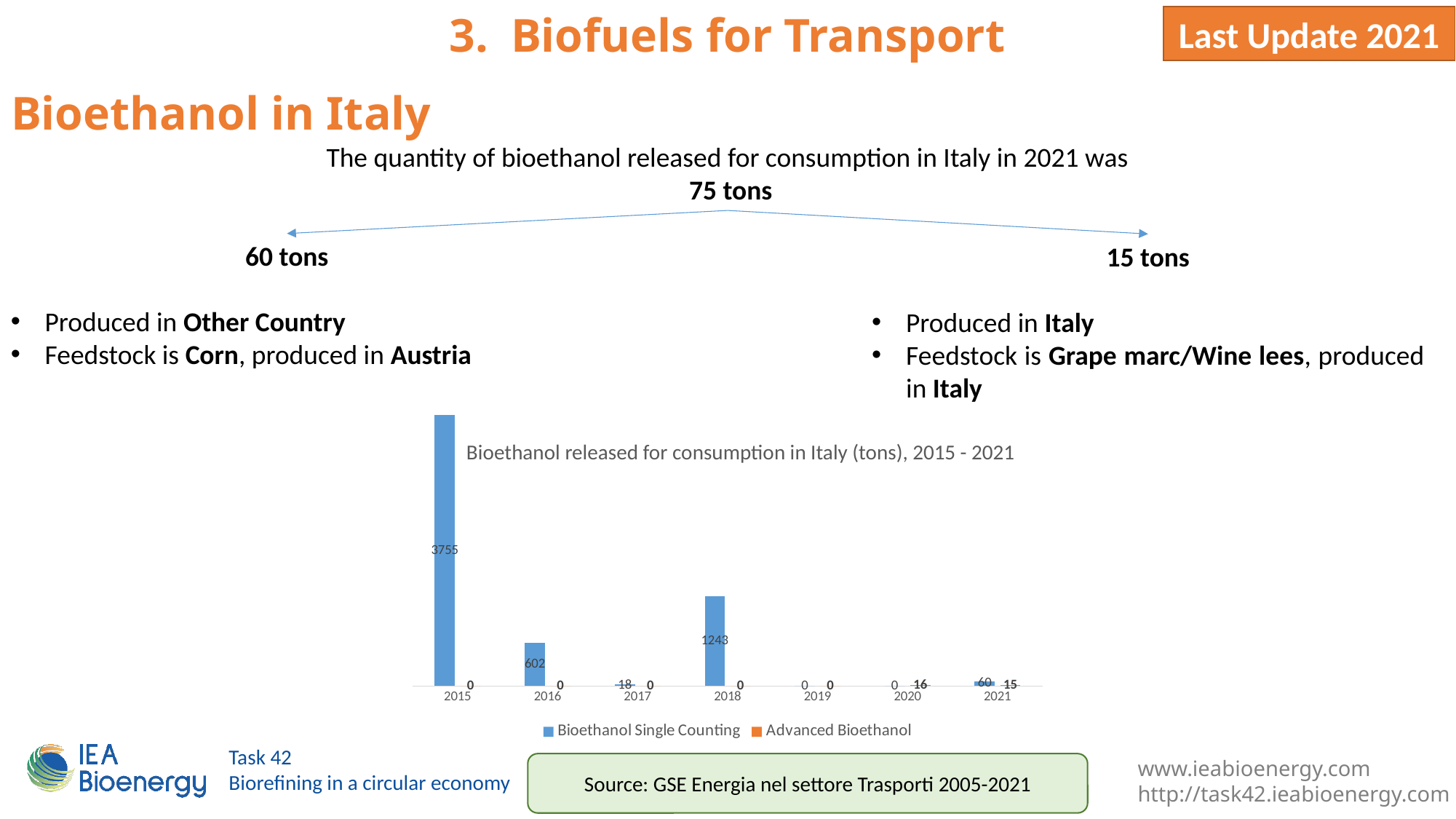
What is the Bioethanol Single Counting value for 2015? 3755 What is the title of the chart? Bioethanol released for consumption in Italy (tons), 2015 - 2021 How many series does the chart legend list? 2 What is the Bioethanol Single Counting value for 2018? 1243 Which is larger, the Bioethanol Single Counting value for 2016 or for 2018? 2018 What is the Advanced Bioethanol value for 2021? 15 What is the total of the two series for 2021? 75 What is the Advanced Bioethanol value for 2020? 16 How many years are shown on the x axis of the chart? 7 Which year has the highest Bioethanol Single Counting value? 2015 What is the difference between the Bioethanol Single Counting values for 2015 and 2018? 2512 What kind of chart is shown on the slide? bar chart